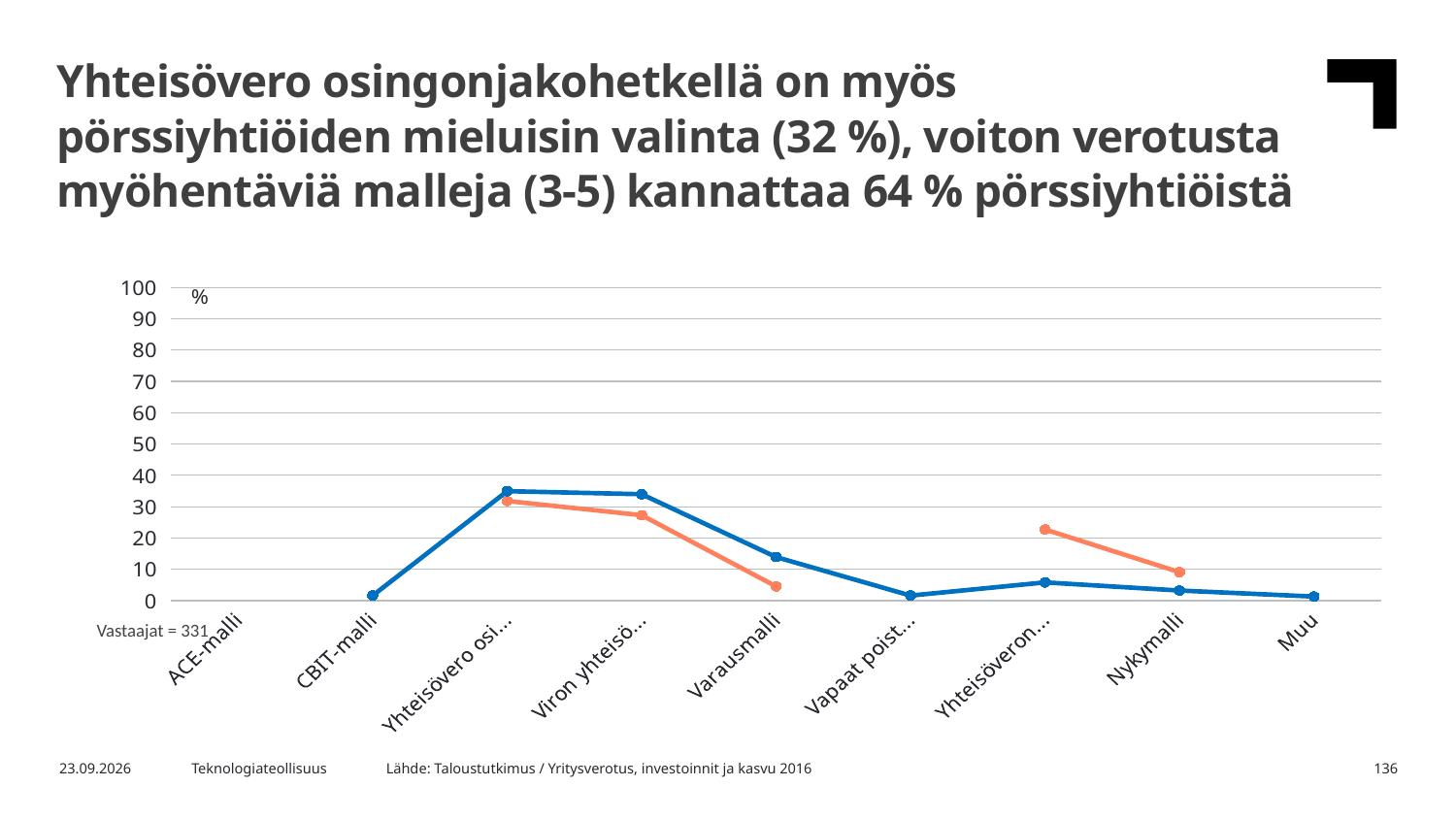
Is the value of the blue line for Muu greater or less than 10? less Is the value of the blue line for Varausmalli greater or less than 10? greater At Varausmalli, which line has the larger value, the blue line or the orange line? blue line Is the value of the blue line for Nykymalli greater or less than 10? less What is the number of respondents (Vastaajat) noted below the chart? 331 Which category has the highest value on the orange line? Yhteisövero osi... How many categories are shown on the x axis of the chart? 9 At Nykymalli, which line has the larger value, the blue line or the orange line? orange line Does the blue line rise or fall from Viron yhteisö... to Vapaat poist...? fall What kind of chart is shown on the slide? line chart